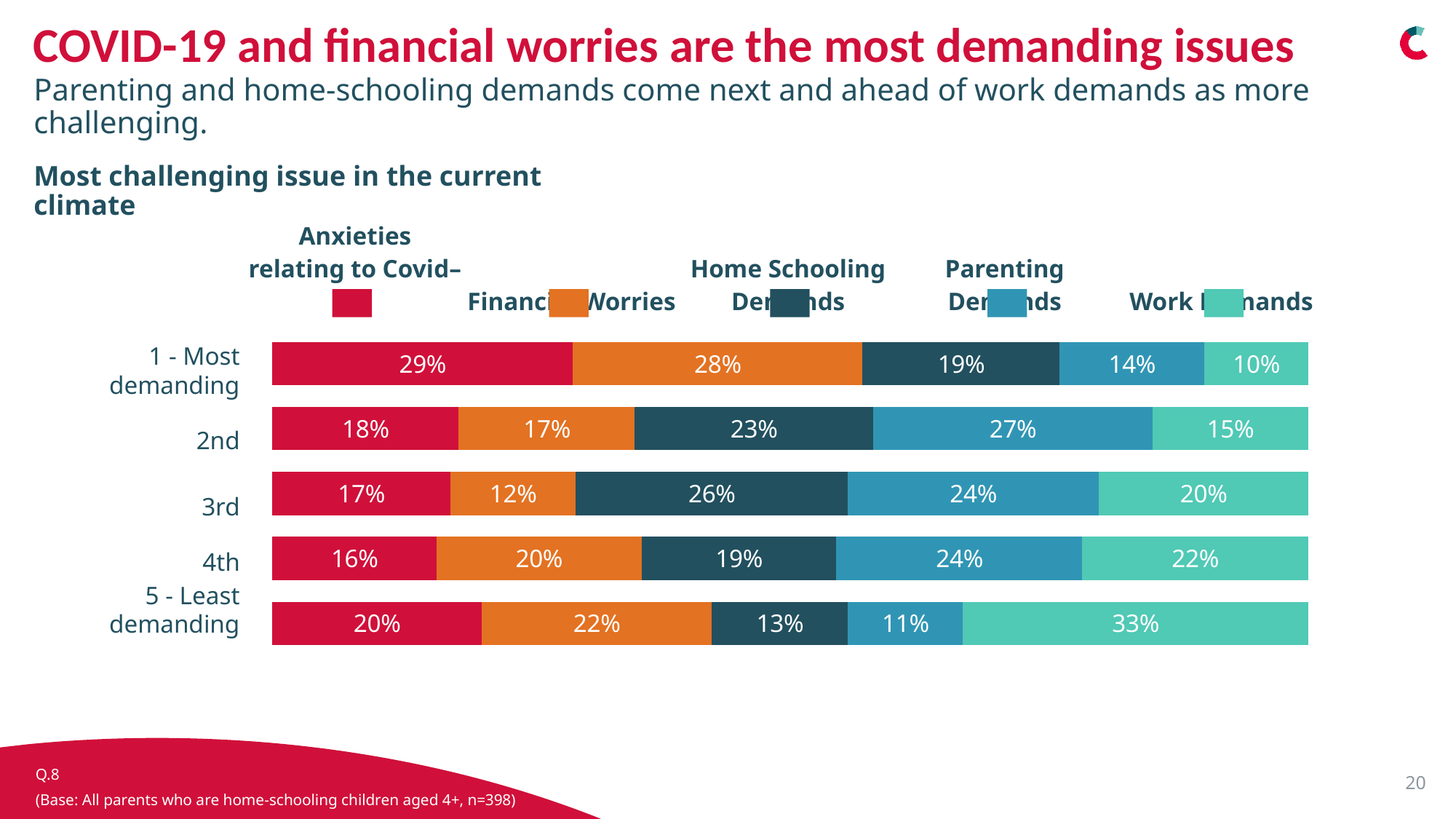
What kind of chart is shown on the slide? Stacked bar chart How many ranking categories are shown on the chart? 5 In the '1 - Most demanding' bar, what is the difference between Anxieties relating to Covid-19 and Work Demands? 19 percentage points What percentage of parents ranked Anxieties relating to Covid-19 as the most demanding issue (1 - Most demanding)? 29% How many series does the legend list? 5 Which series has the smallest share in the '5 - Least demanding' bar? Parenting Demands Which series has the largest share in the '1 - Most demanding' bar? Anxieties relating to Covid-19 In the '4th' bar, which is larger: Financial Worries or Parenting Demands? Parenting Demands What is the value for Home Schooling Demands in the '3rd' bar? 26% What is the value for Work Demands in the '5 - Least demanding' bar? 33% What is the title of the chart? Most challenging issue in the current climate What is the value for Parenting Demands in the '2nd' bar? 27%